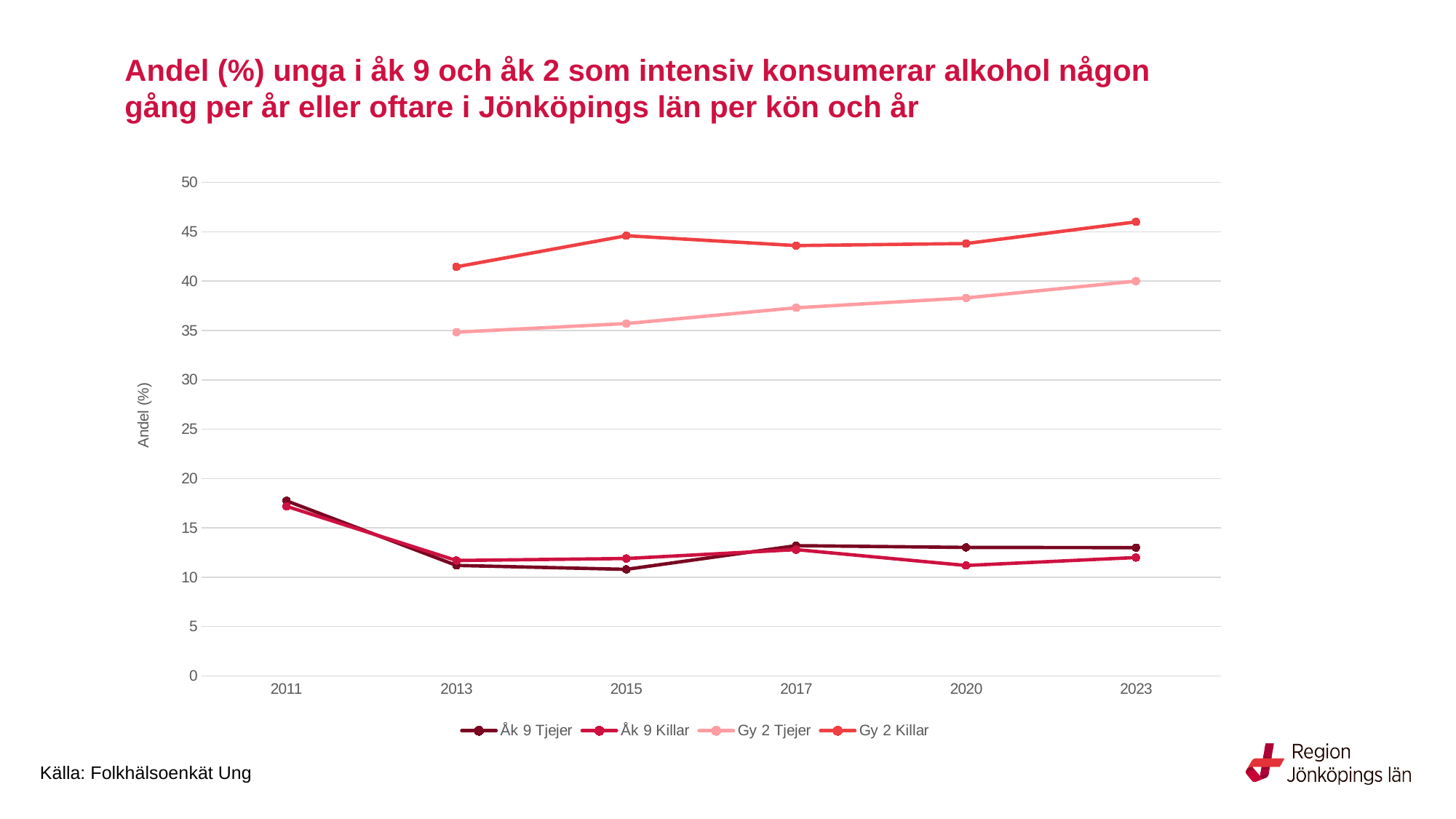
Which series has the highest value in 2023? Gy 2 Killar Which series has the lowest value in 2015? Åk 9 Tjejer How many years are shown on the x axis? 6 What is the label on the y axis? Andel (%) In 2015, which is larger: Gy 2 Killar or Gy 2 Tjejer? Gy 2 Killar Is the value for Gy 2 Tjejer in 2013 greater or less than 40? less What kind of chart is shown on the slide? line chart Is the value for Åk 9 Tjejer in 2011 greater or less than 15? greater Is the value for Gy 2 Killar in 2023 greater or less than 45? greater How many series does the legend list? 4 Does the Gy 2 Tjejer line rise or fall from 2013 to 2023? rises